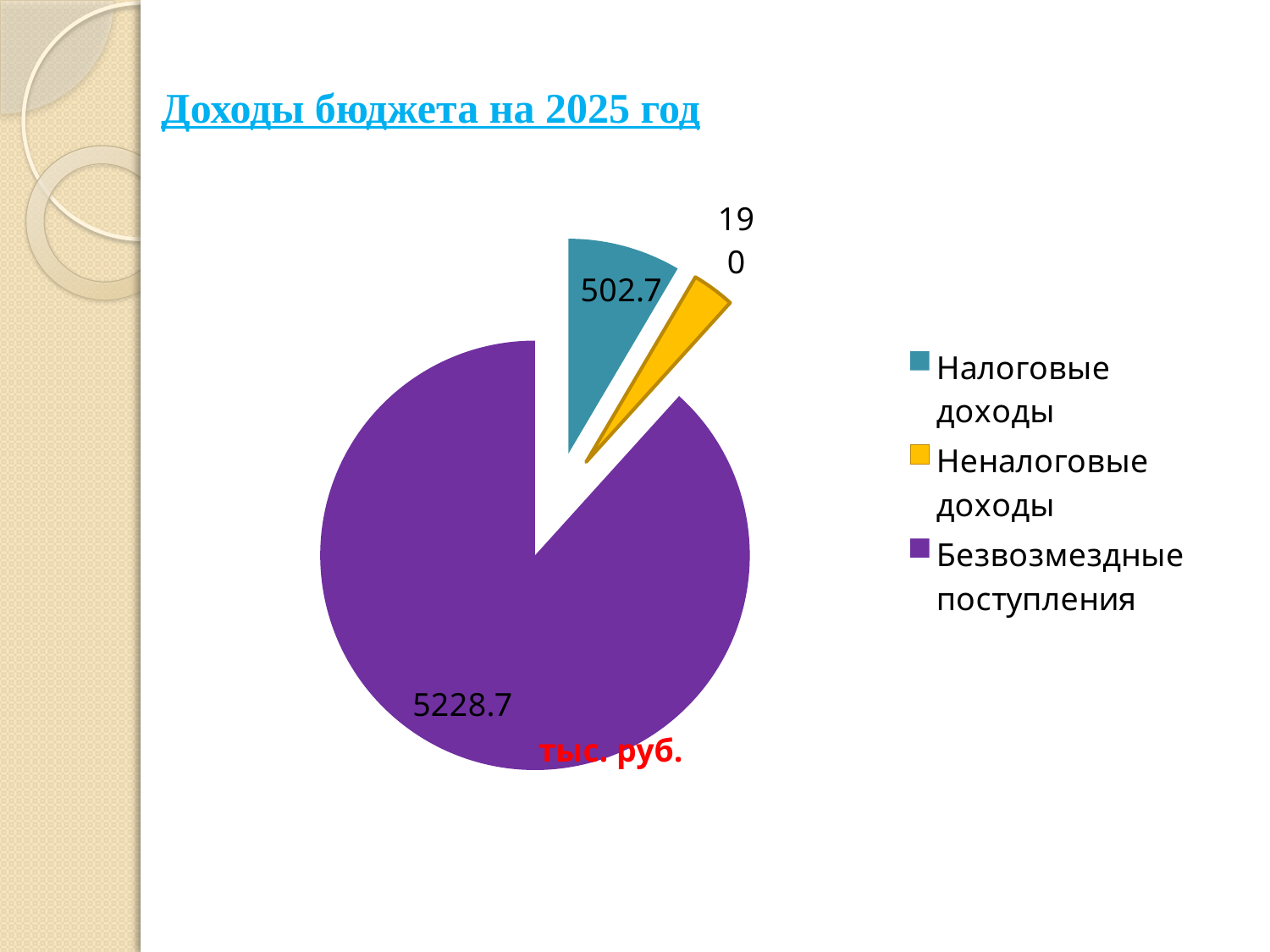
What is the difference between Безвозмездные поступления and Налоговые доходы? 4726 What is the value for Безвозмездные поступления? 5228.7 What type of chart is shown on the slide? Pie chart What is the value for Неналоговые доходы? 190 What is the difference between Налоговые доходы and Неналоговые доходы? 312.7 What is the value for Налоговые доходы? 502.7 Which category has the largest slice of the pie? Безвозмездные поступления Which category has the smallest slice of the pie? Неналоговые доходы What is the title of the chart? Доходы бюджета на 2025 год Which is larger, Налоговые доходы or Неналоговые доходы? Налоговые доходы How many categories does the pie chart have? 3 What unit is indicated on the chart? тыс. руб.